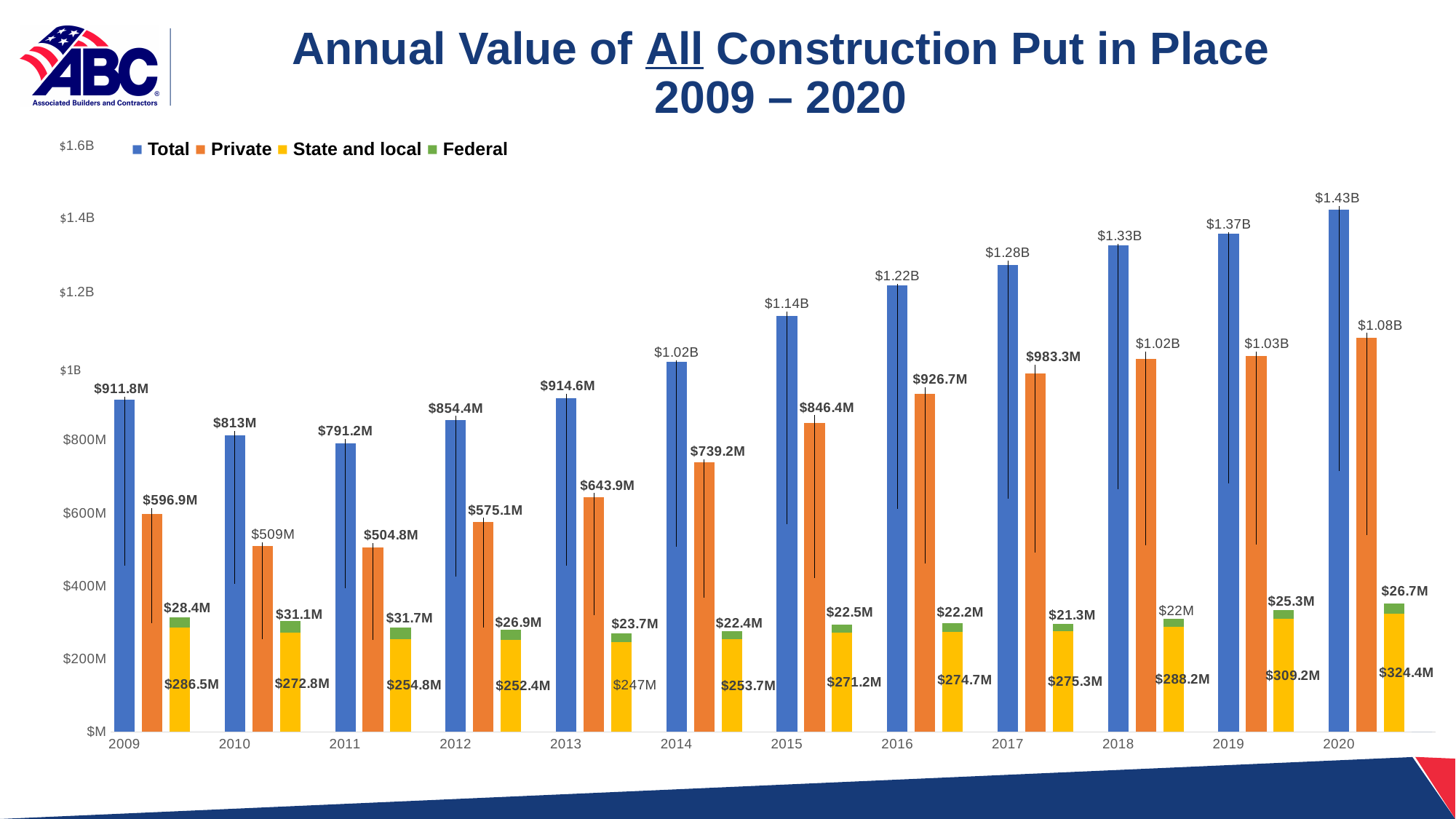
What is the State and local value for 2020? $324.4M How many years are shown on the x axis? 12 What is the difference between the Private value in 2009 and in 2010? $87.9M How many series does the legend list? 4 Which is larger: the Federal value in 2009 or the Federal value in 2020? 2009 What is the Total value of construction put in place in 2009? $911.8M In which year is the Total value lowest? 2011 What kind of chart is shown on the slide? Bar chart In which year is the State and local value lowest? 2013 In which year is the Total value highest? 2020 What is the Federal value for 2009? $28.4M What is the Private value for 2020? $1.08B